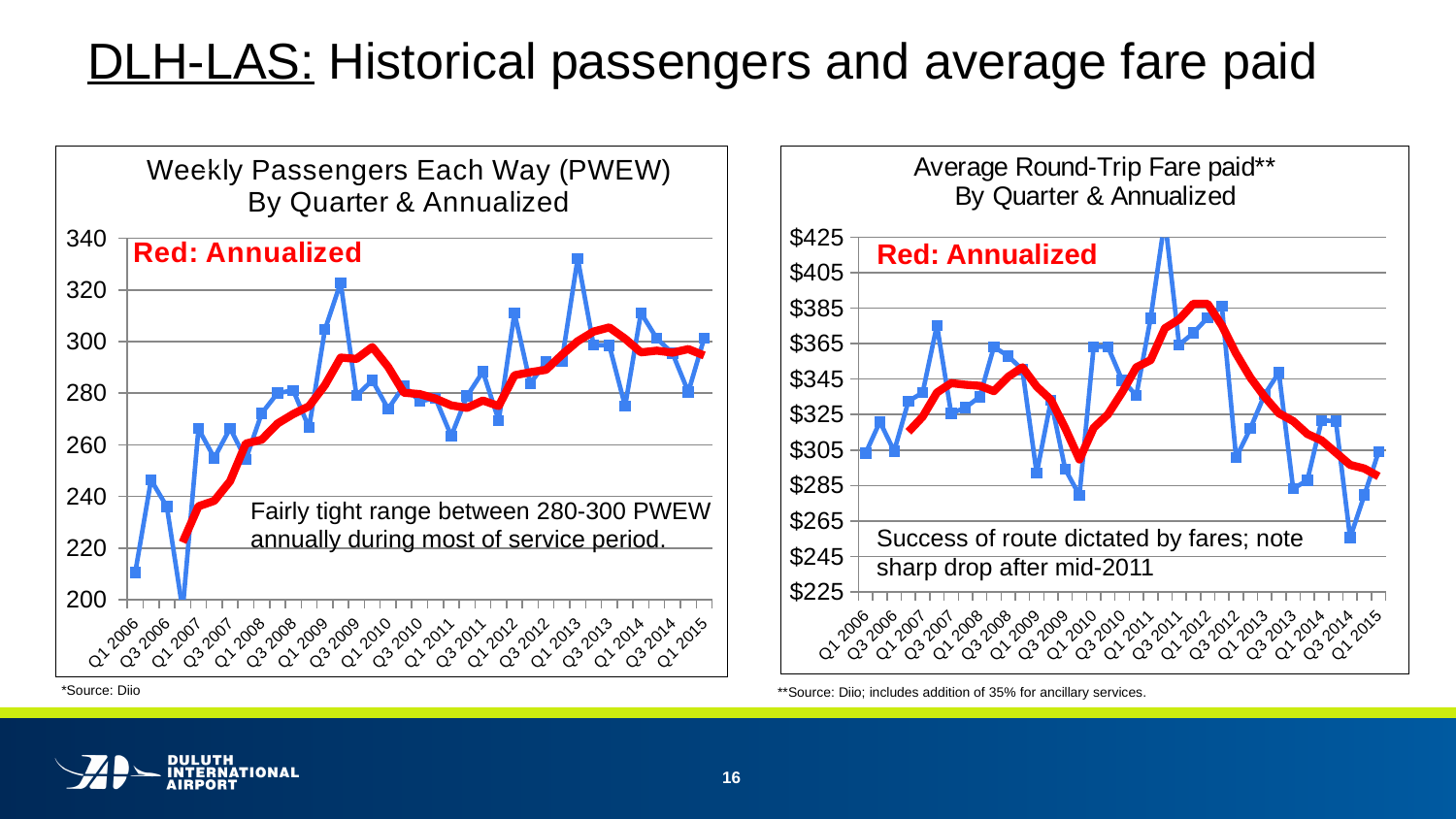
In the 'Weekly Passengers Each Way (PWEW)' chart, which quarter has the highest quarterly value? Q1 2013 In both charts, what does the red line represent? Annualized What kind of chart is the 'Weekly Passengers Each Way (PWEW)' chart on the left? line chart In the 'Weekly Passengers Each Way (PWEW)' chart, is the quarterly value for Q1 2013 greater or less than 320? greater In the 'Average Round-Trip Fare paid' chart, which quarter has the highest quarterly fare? Q2 2011 In the 'Weekly Passengers Each Way (PWEW)' chart, which quarter has the lowest quarterly value? Q4 2006 In the 'Average Round-Trip Fare paid' chart, is the quarterly fare for Q3 2011 greater or less than $405? less What kind of chart is the 'Average Round-Trip Fare paid' chart on the right? line chart In the 'Average Round-Trip Fare paid' chart, does the red annualized line rise or fall from Q1 2012 to Q1 2015? fall In the 'Average Round-Trip Fare paid' chart, which quarter has the lowest quarterly fare? Q3 2014 In the 'Weekly Passengers Each Way (PWEW)' chart, is the quarterly value for Q1 2006 greater or less than 220? less